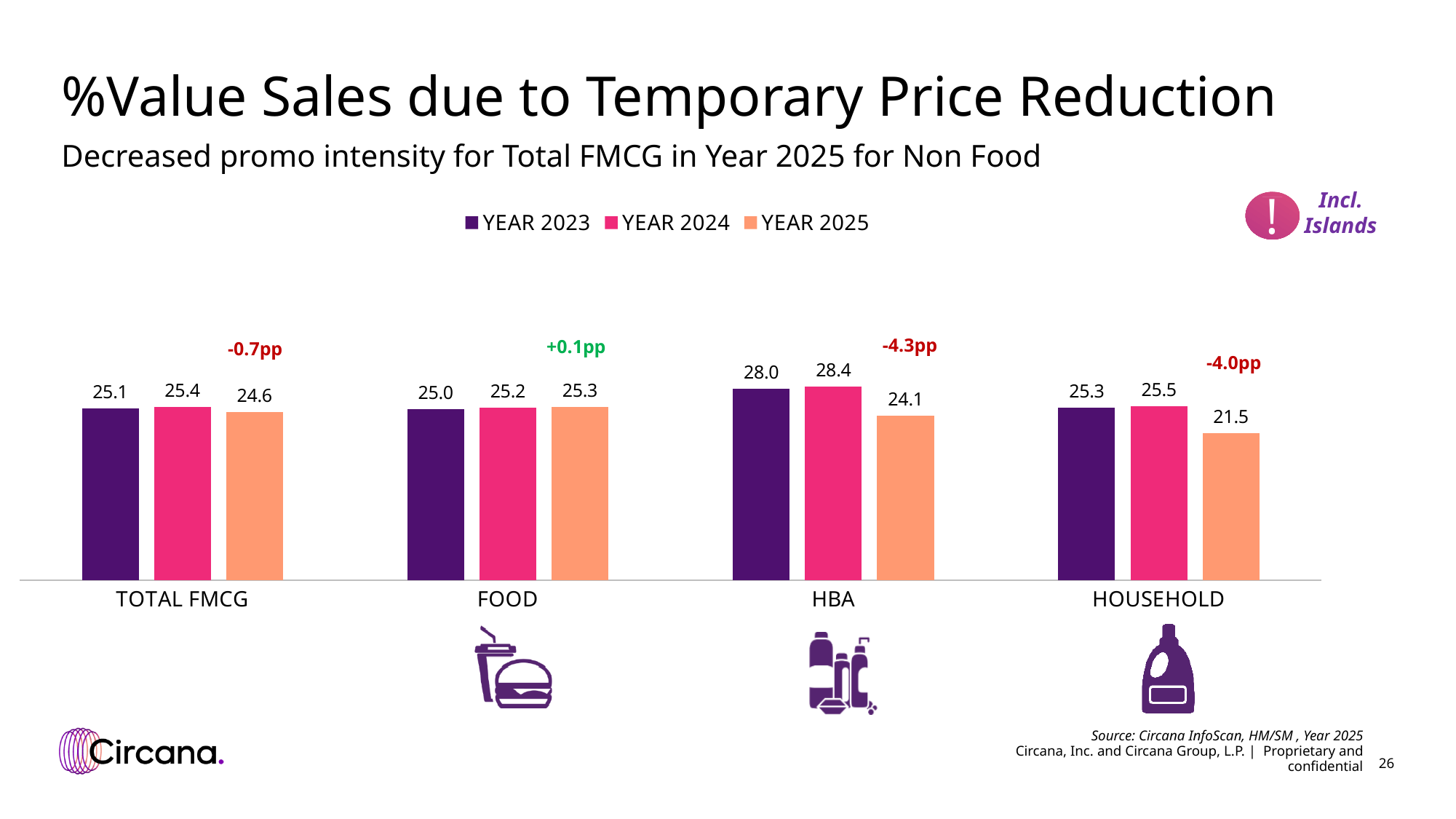
Which category has the lowest value in YEAR 2025? HOUSEHOLD What is the value for FOOD in YEAR 2024? 25.2 What kind of chart is shown on the slide? Bar chart Which is larger, the YEAR 2025 value for FOOD or the YEAR 2025 value for HBA? FOOD What is the difference between the YEAR 2023 and YEAR 2025 values for TOTAL FMCG? 0.5 What is the value for HBA in YEAR 2025? 24.1 What is the value for HOUSEHOLD in YEAR 2023? 25.3 Which category has the highest value in YEAR 2024? HBA How many categories are shown on the x axis? 4 How many series does the legend list? 3 What is the difference between the YEAR 2024 and YEAR 2025 values for HOUSEHOLD? 4.0 What change in percentage points is annotated above the HBA bars? -4.3pp